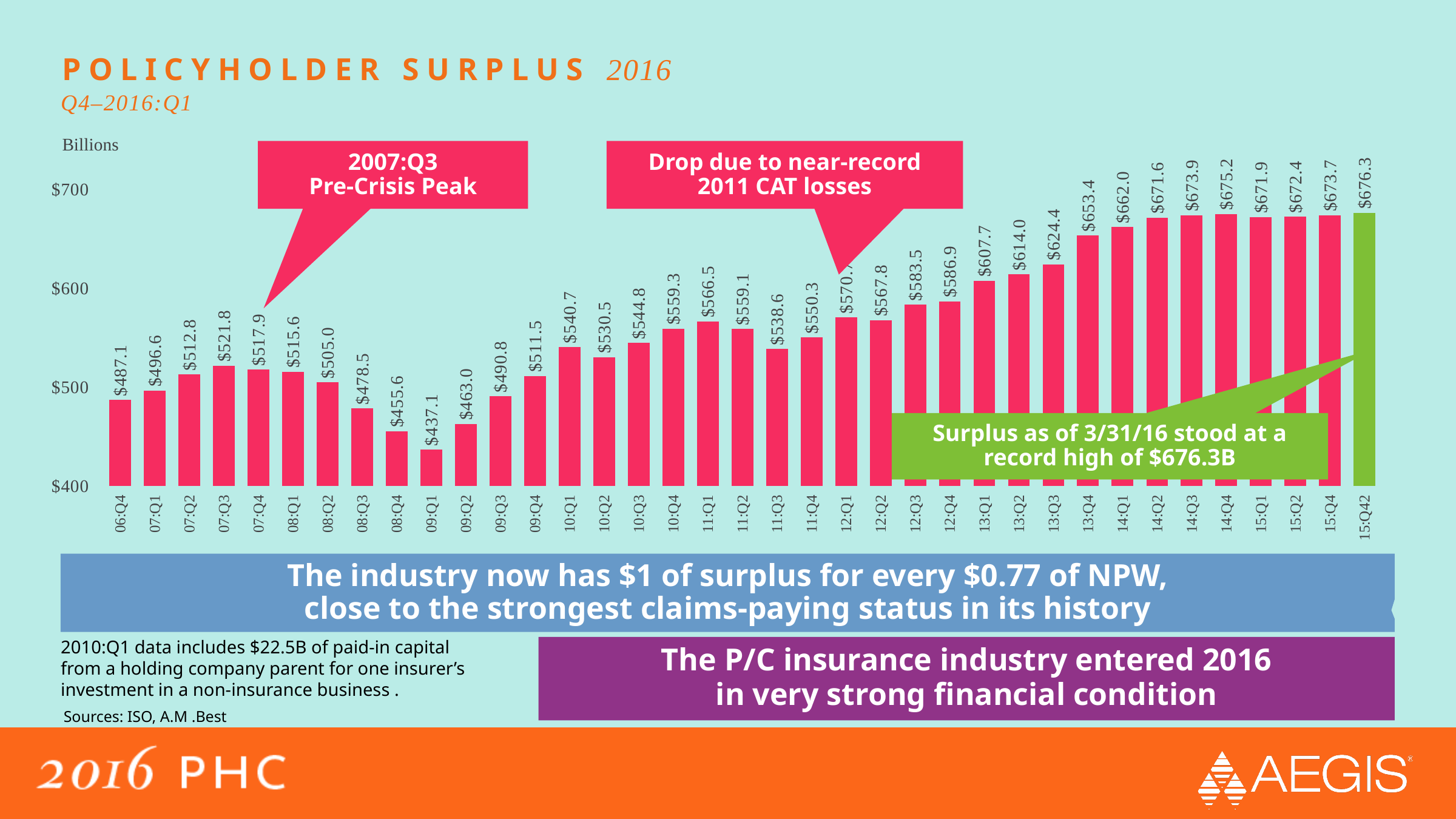
What is the policyholder surplus value for 07:Q3? $521.8 Which quarter has the lowest policyholder surplus? 09:Q1 How many bars are plotted on the chart? 37 What is the policyholder surplus value for 09:Q1? $437.1 What is the difference between the surplus in 07:Q3 and the surplus in 09:Q1? $84.7 What is the highest policyholder surplus value shown on the chart? $676.3 Which quarter has a larger surplus, 10:Q1 or 10:Q2? 10:Q1 What kind of chart is shown on the slide? bar chart What colour is the last bar on the chart, which differs from the others? green Do the surplus values generally rise or fall from 12:Q2 to 14:Q4? rise What is the policyholder surplus value for 13:Q4? $653.4 Is the surplus value for 08:Q4 greater or less than $500? less